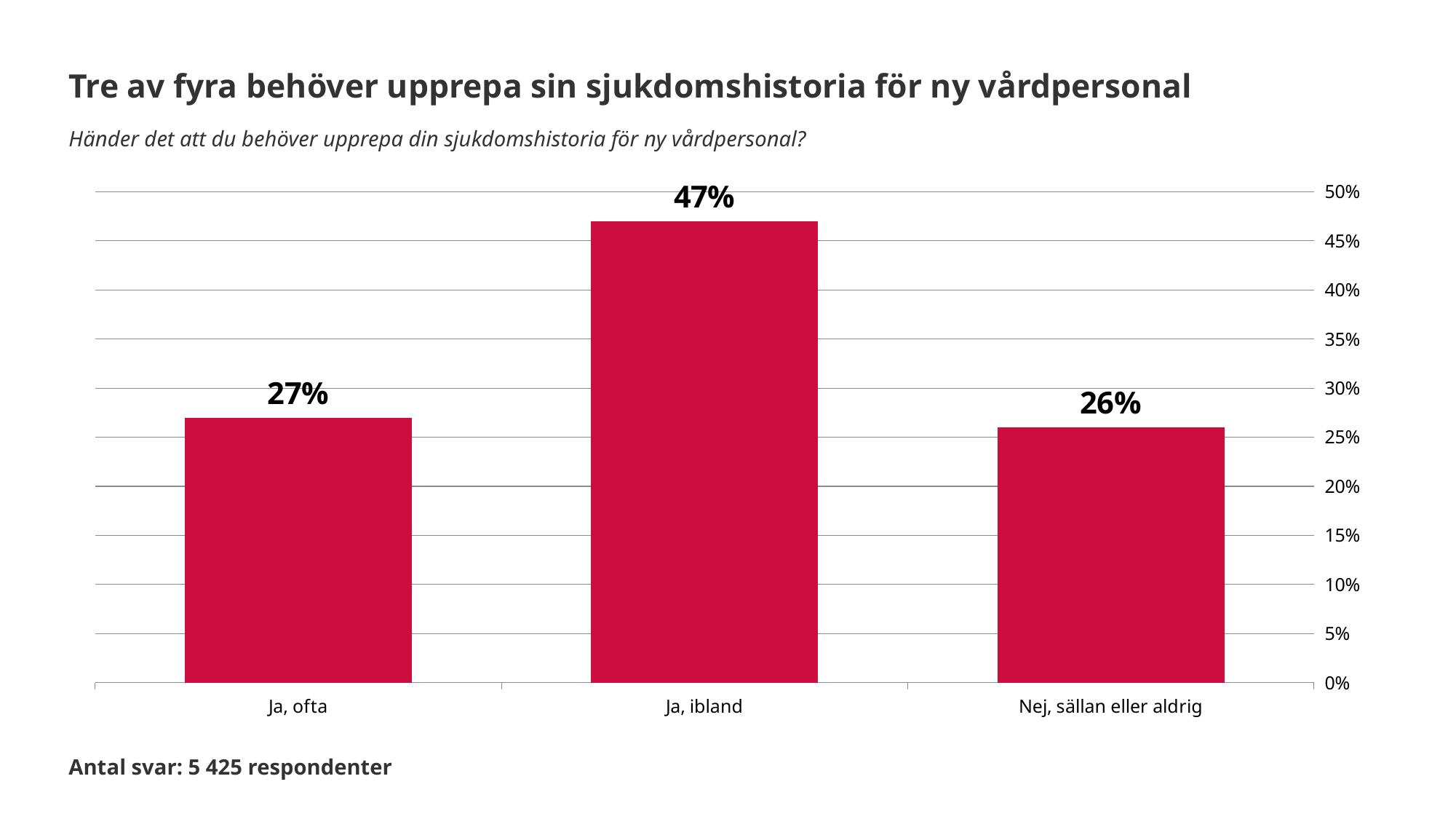
Which category has the highest value? Ja, ibland How many categories are shown on the x axis? 3 Is the value for "Ja, ibland" greater or less than 40%? greater Is the value for "Nej, sällan eller aldrig" greater or less than 30%? less What is the difference between the values for "Ja, ibland" and "Ja, ofta"? 20% What is the value for "Ja, ofta"? 27% Which is larger, the value for "Ja, ibland" or the value for "Nej, sällan eller aldrig"? Ja, ibland What is the value for "Ja, ibland"? 47% What is the title of the chart? Tre av fyra behöver upprepa sin sjukdomshistoria för ny vårdpersonal What kind of chart is shown on the slide? Bar chart What is the value for "Nej, sällan eller aldrig"? 26% What is the difference between the values for "Ja, ofta" and "Nej, sällan eller aldrig"? 1%